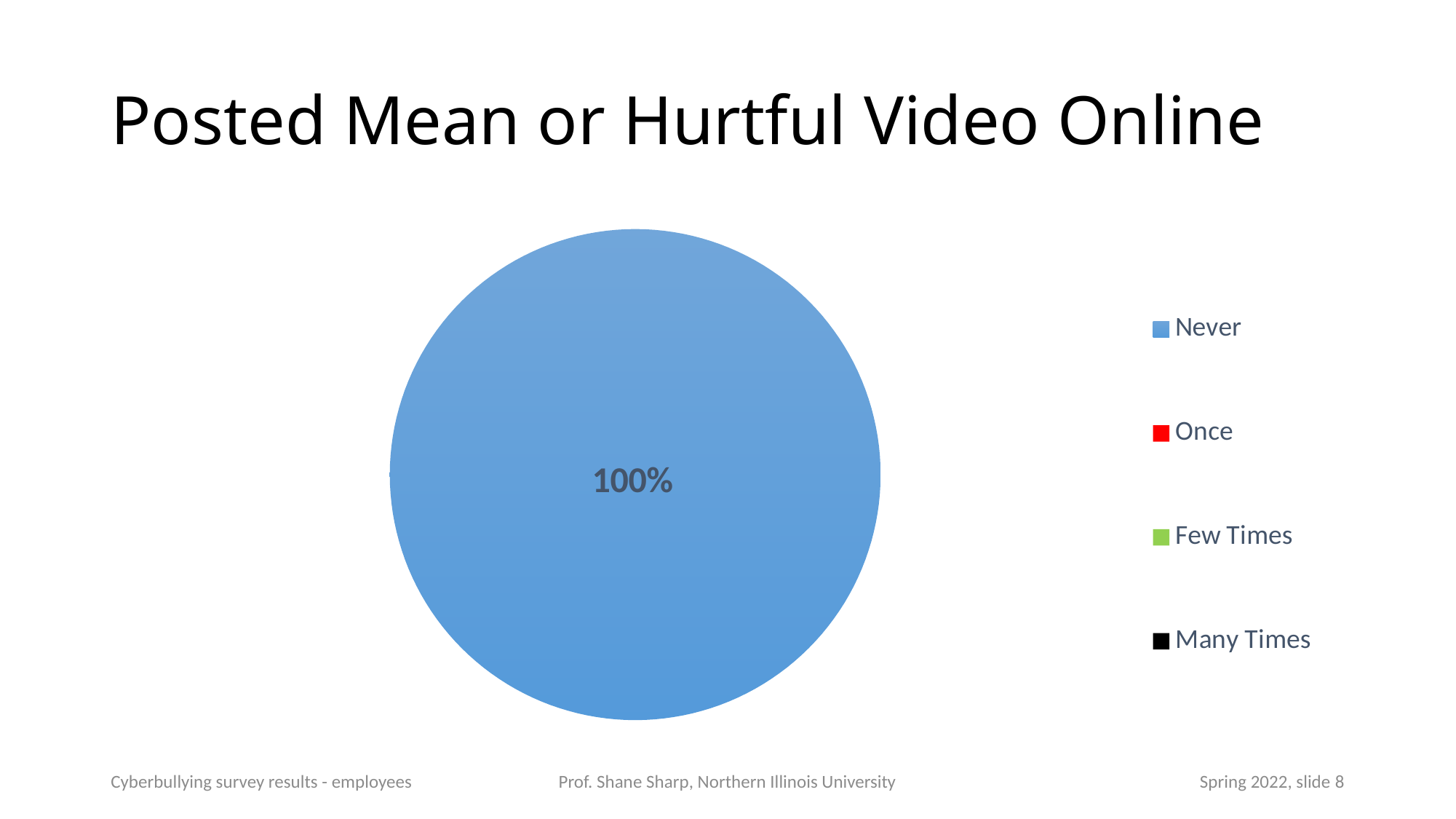
How many entries does the legend list? 4 What kind of chart is shown on the slide? pie chart Which category is larger, Never or Once? Never Is the share for Never greater or less than 50%? greater What colour is the Never slice of the pie? blue What is the title of the slide? Posted Mean or Hurtful Video Online Which category has the largest share of the pie? Never What share of the pie does the Never slice take? 100% What is the only data label printed on the pie chart? 100%